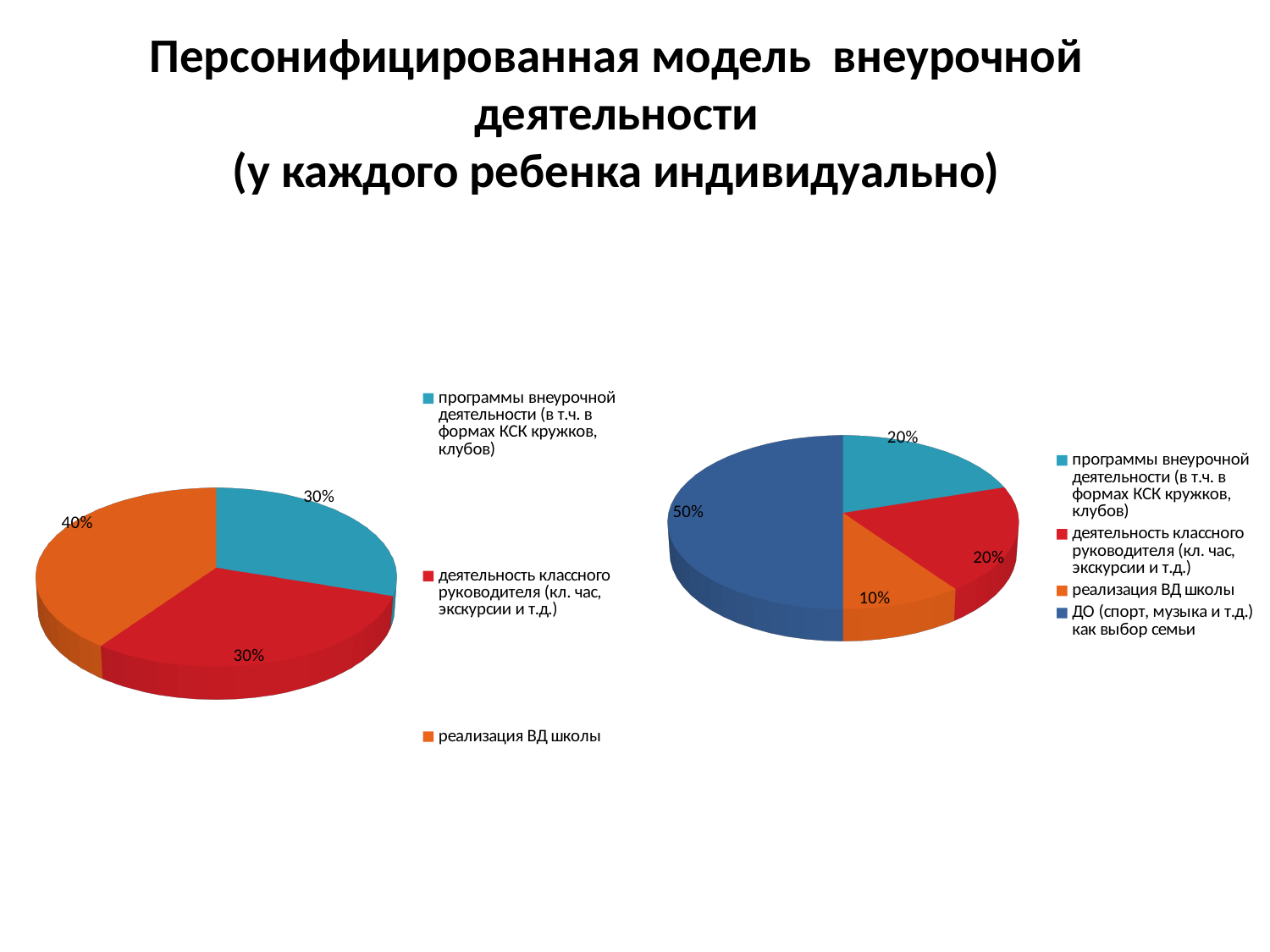
In the right pie chart, which category has the smallest slice? реализация ВД школы What type of chart is the chart on the right of the slide? Pie chart How many slices does the left pie chart have? 3 In the right pie chart, which category has the largest slice? ДО (спорт, музыка и т.д.) как выбор семьи In the left pie chart, what share is shown for "программы внеурочной деятельности (в т.ч. в формах КСК кружков, клубов)"? 30% In the left pie chart, what share is shown for "реализация ВД школы"? 40% In the right pie chart, what share is shown for "деятельность классного руководителя (кл. час, экскурсии и т.д.)"? 20% In the right pie chart, what share is shown for "реализация ВД школы"? 10% In the right pie chart, what is the difference between the share for "ДО (спорт, музыка и т.д.) как выбор семьи" and the share for "реализация ВД школы"? 40% In the left pie chart, which category has the largest slice? реализация ВД школы In the right pie chart, what share is shown for "ДО (спорт, музыка и т.д.) как выбор семьи"? 50% How many entries does the legend of the right pie chart list? 4